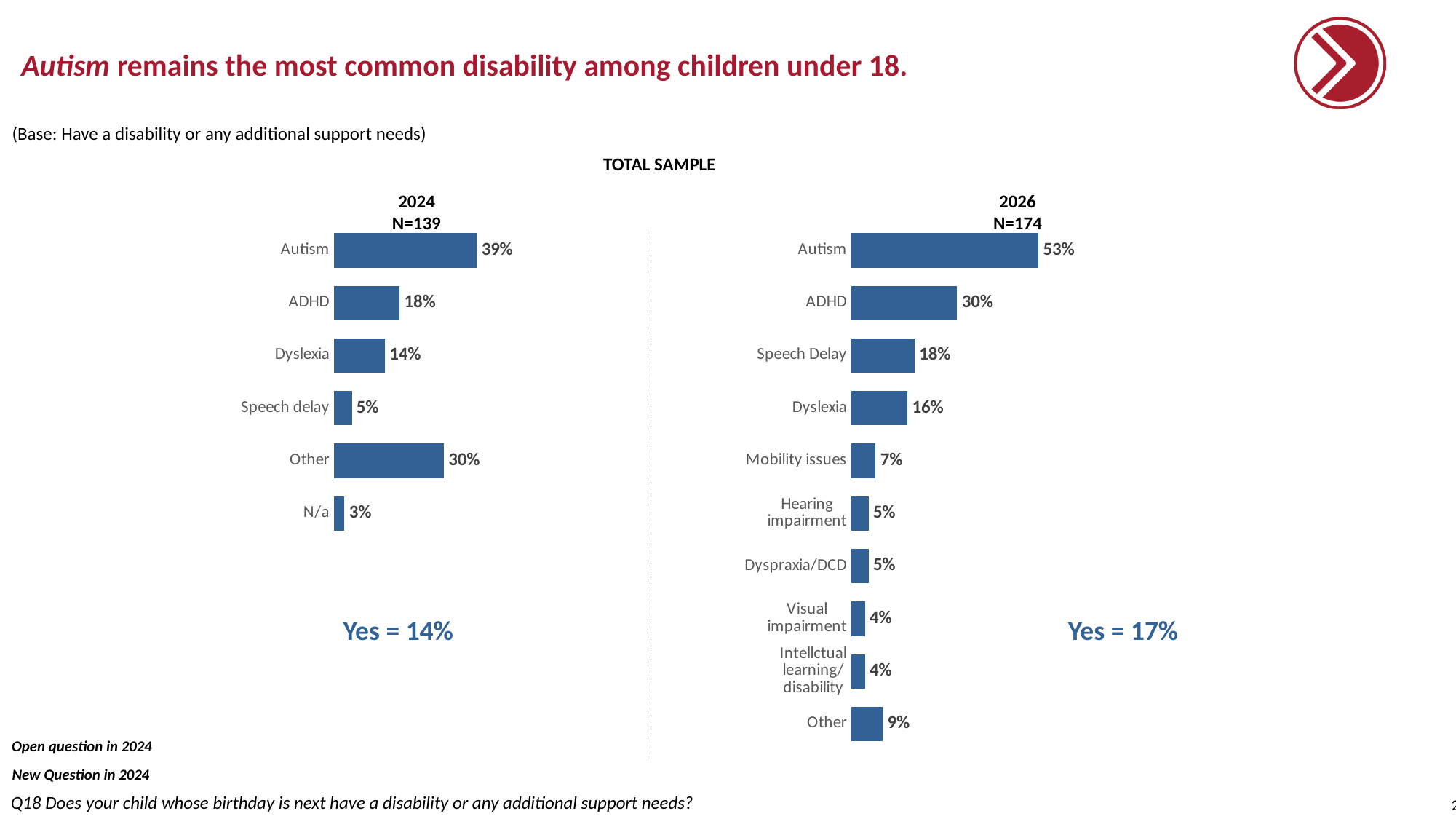
How many categories are shown in the 2024 chart? 6 How many categories are shown in the 2026 chart? 10 What is the difference between the Autism values in the 2026 chart and the 2024 chart? 14 percentage points What is the sample size (N) shown for the 2026 chart? N=174 What type of chart is used on this slide? Bar chart In the 2024 chart, which is larger: the value for Other or the value for ADHD? Other In the 2024 chart, which category has the lowest value? N/a In the 2026 chart, what is the difference between Speech Delay and Dyslexia? 2 percentage points In the 2026 chart, which category has the highest value? Autism In the 2026 chart, what is the value for ADHD? 30% In the 2026 chart, what is the value for Mobility issues? 7% In the 2024 chart, what is the value for Autism? 39%